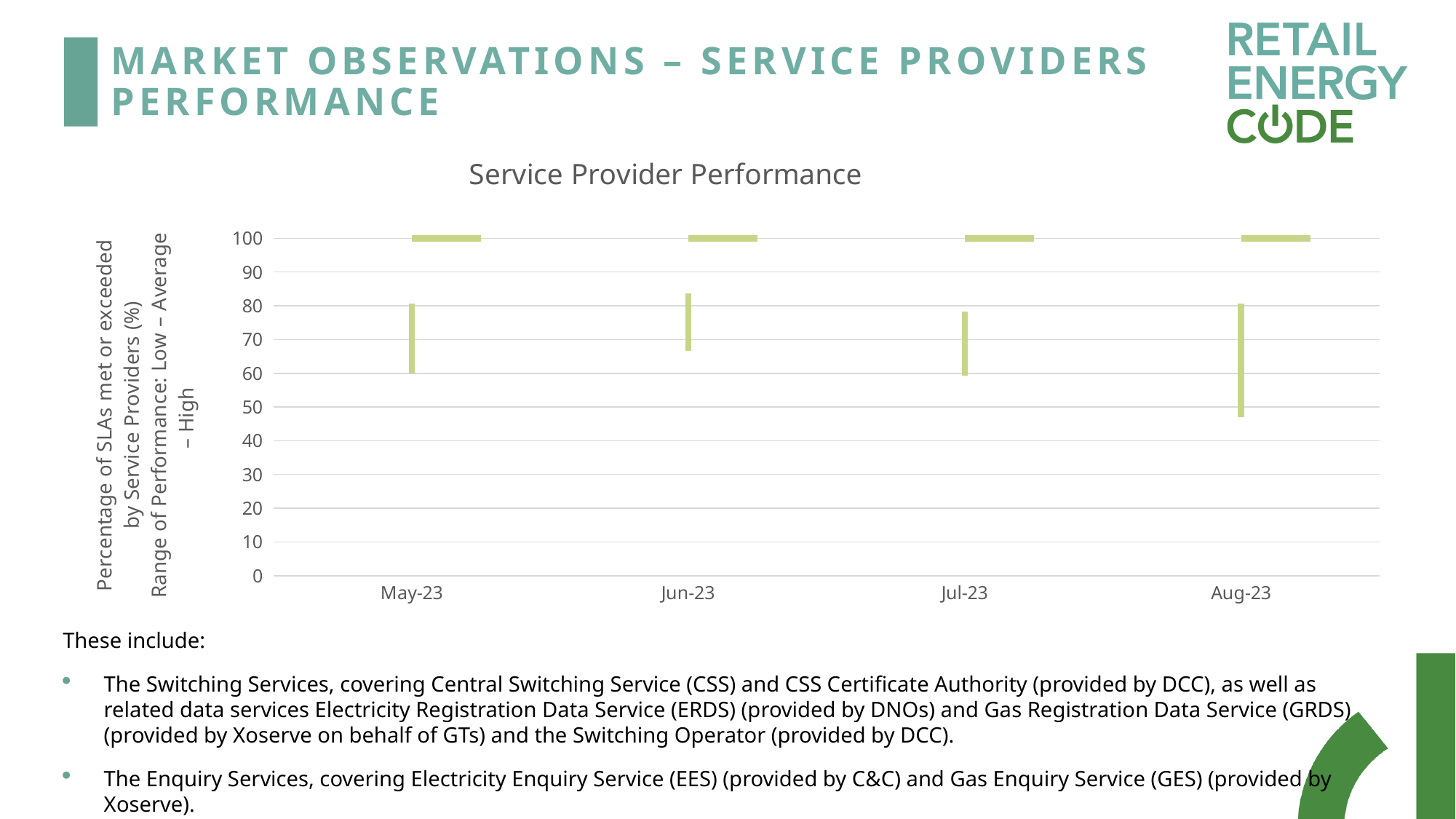
Is the low end of the range for Jun-23 greater or less than 60? greater Which month's vertical range line reaches the highest point? Jun-23 What is the highest value shown on the y axis of the chart? 100 How many months are shown on the x axis of the chart? 4 Is the low end of the range for May-23 greater or less than 50? greater Which has the higher low end of its range, May-23 or Jun-23? Jun-23 Which has the higher low end of its range, Jul-23 or Aug-23? Jul-23 At what value do the short horizontal markers sit for every month in the chart? 100 Is the low end of the range for Aug-23 greater or less than 50? less Which month has the lowest bottom end of its performance range? Aug-23 What is the title of the chart? Service Provider Performance